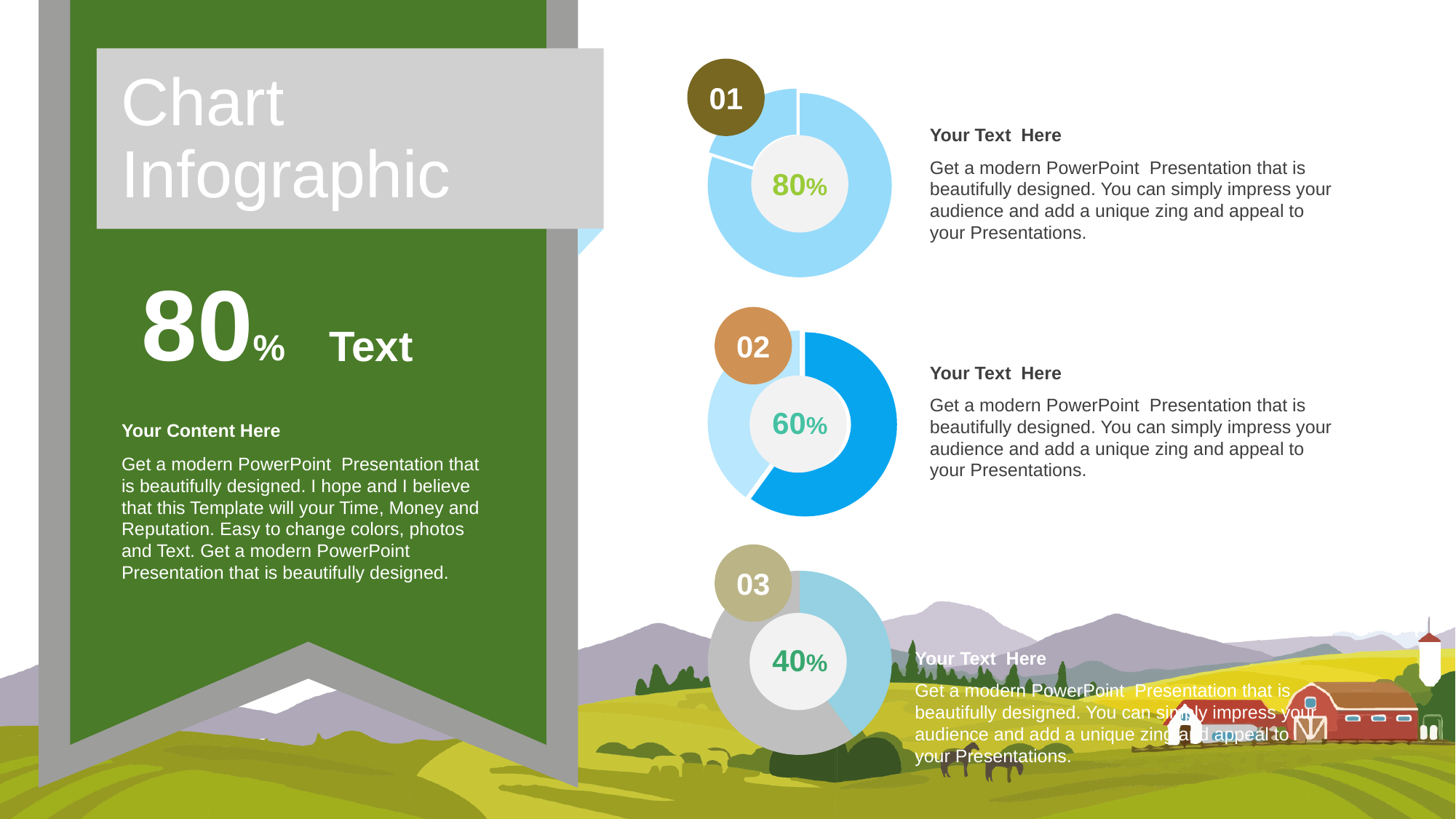
What is the difference between the percentage in chart 01 and the percentage in chart 03? 40% What kind of chart is used for each of the three numbered items on the slide? Donut chart How many donut charts are shown on the slide? 3 What percentage is shown in the centre of the donut chart labelled 02? 60% What is the difference between the percentage in chart 01 and the percentage in chart 02? 20% Do the percentages in the donut charts increase or decrease going from chart 01 down to chart 03? Decrease What is the title of the slide containing the donut charts? Chart Infographic Which shows a larger percentage, the donut chart labelled 02 or the donut chart labelled 03? 02 Which of the three donut charts (01, 02 or 03) shows the highest percentage? 01 Which of the three donut charts (01, 02 or 03) shows the lowest percentage? 03 What percentage is shown in the centre of the donut chart labelled 03? 40% What percentage is shown in the centre of the donut chart labelled 01? 80%